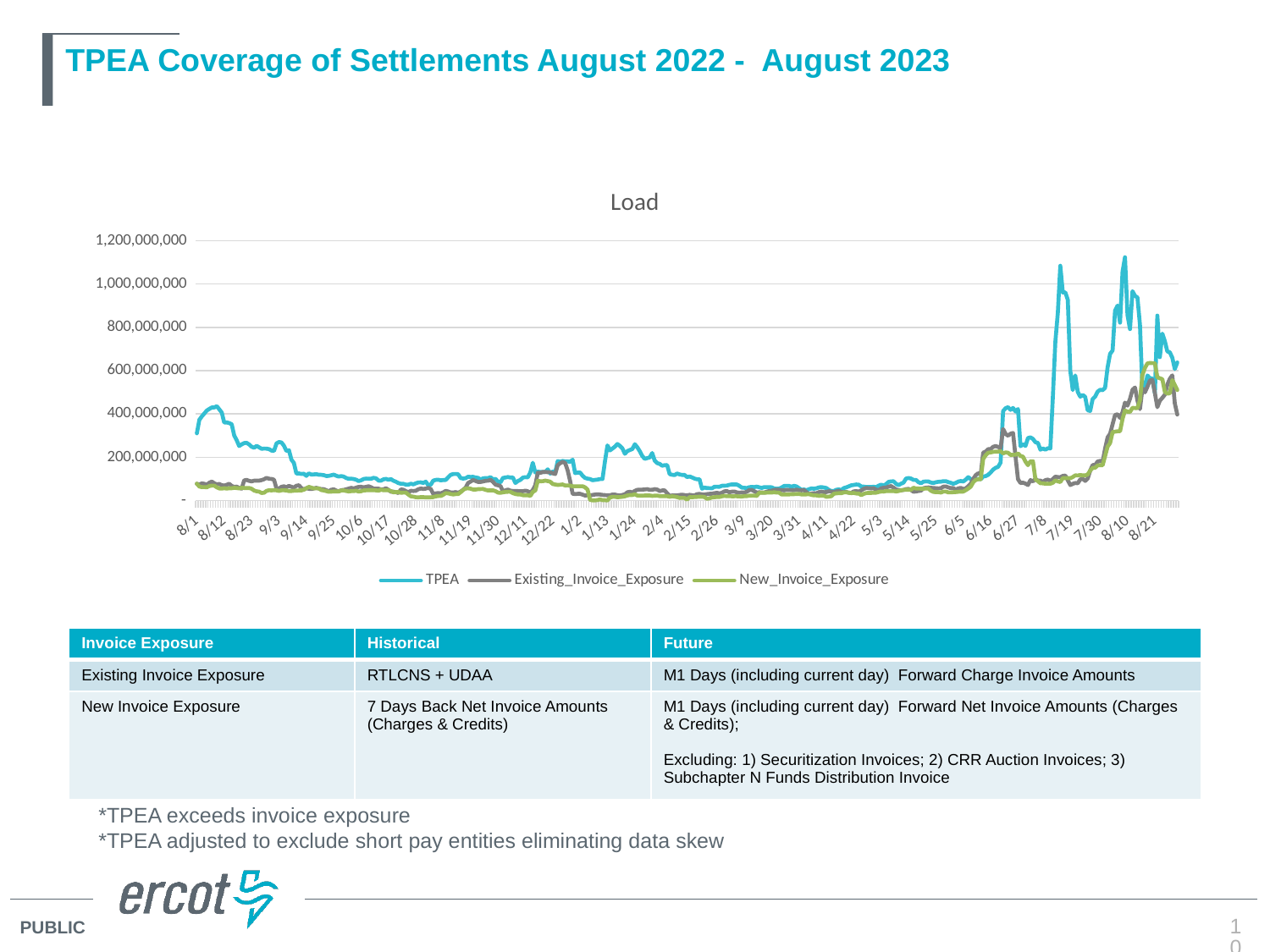
Is the value of the New_Invoice_Exposure series on 4/22 greater or less than 400,000,000? less What is the title of the chart? Load Is the value of the TPEA series on 8/12 greater or less than 200,000,000? greater How many series does the chart legend list? 3 On 8/12, which series has the larger value, TPEA or Existing_Invoice_Exposure? TPEA What is the highest value shown on the vertical axis? 1,200,000,000 Does the TPEA series rise or fall between 6/27 and 7/19? rise Which series is drawn in the light blue colour? TPEA What kind of chart is shown on the slide? line chart Is the peak value of the TPEA series around 7/19 greater or less than 1,000,000,000? greater Which series reaches the highest value on the chart? TPEA